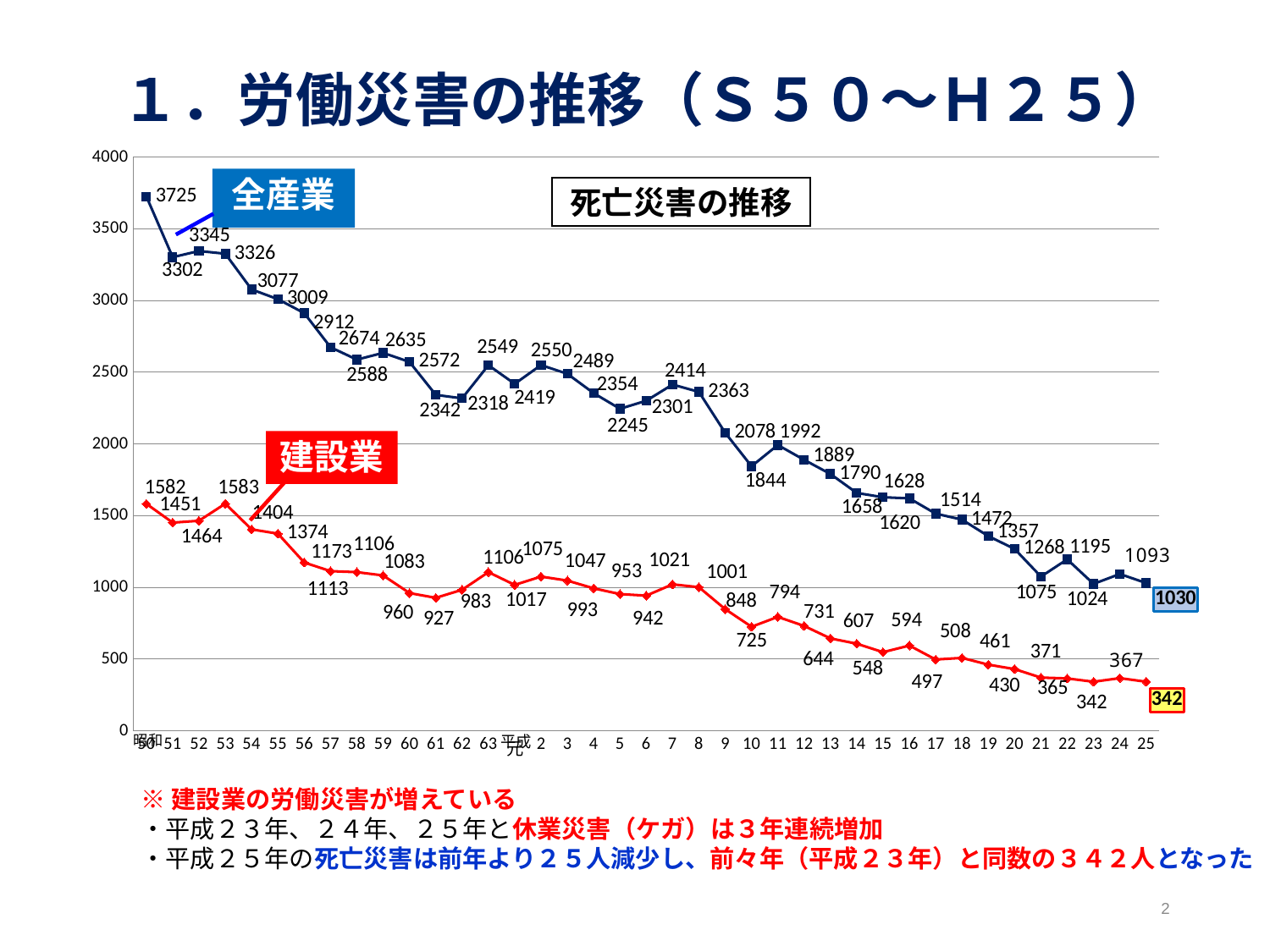
What is the value for 建設業 in 平成25? 342 In which year is the 全産業 value highest? 昭和50 What type of chart is shown on the slide? line chart How many series are plotted in the chart? 2 Overall, do the 全産業 values rise or fall from 昭和50 to 平成25? fall What is the title shown inside the chart area? 死亡災害の推移 What is the difference between the 全産業 and 建設業 values in 平成25? 688 What is the value for 全産業 in 平成25? 1030 By how much did the 建設業 value fall from 平成24 to 平成25? 25 What is the lowest value plotted for 建設業? 342 What is the value for 全産業 in 昭和50? 3725 What is the value for 建設業 in 平成10? 725